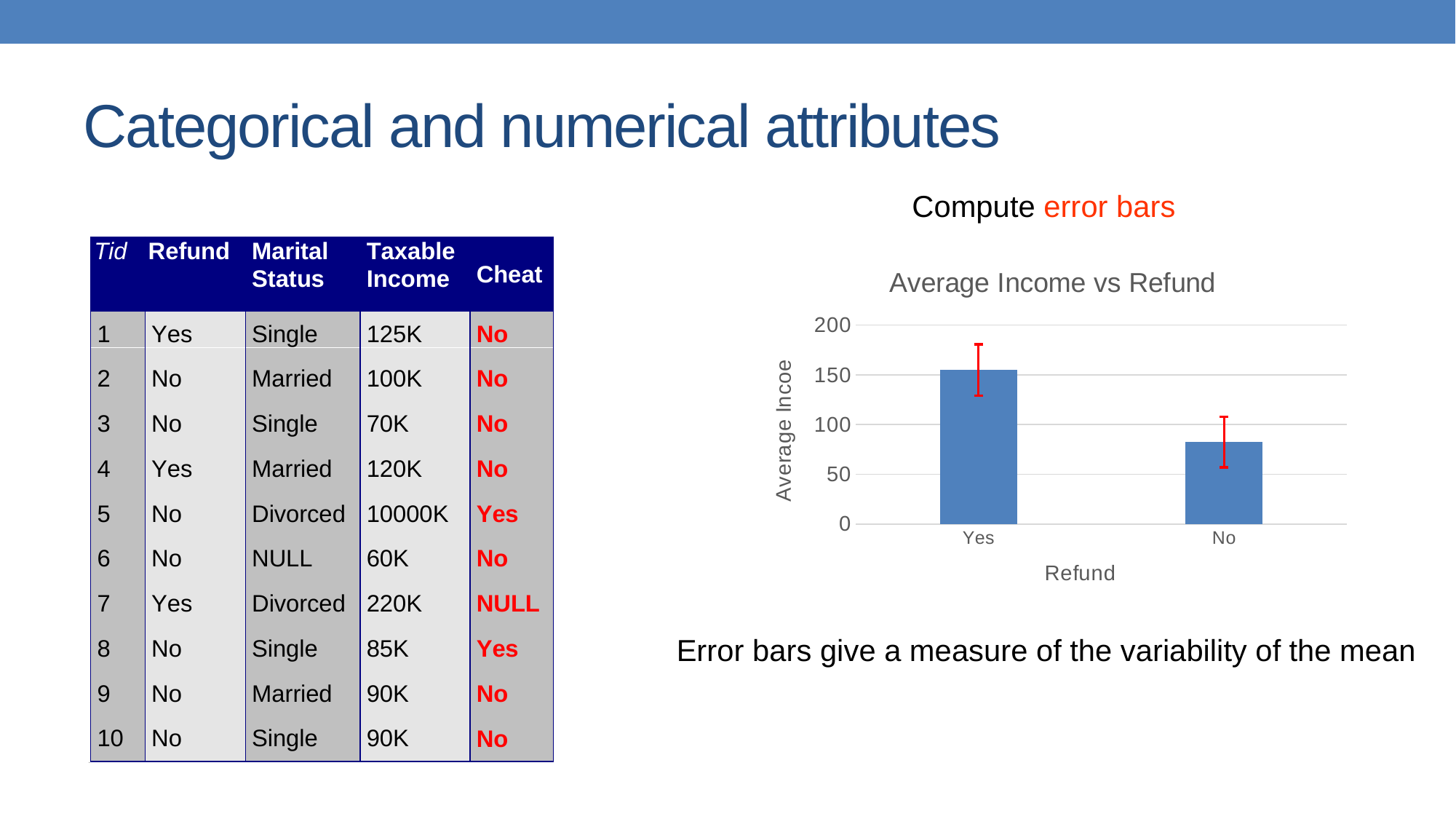
Which bar is taller, Yes or No? Yes Is the value for Yes greater or less than 200? less Is the value for Yes greater or less than 100? greater Which category has the highest bar in the chart? Yes How many categories are plotted on the x axis of the chart? 2 Is the value for No greater or less than 50? greater What kind of chart is shown on the slide? bar chart What is the label of the x axis of the chart? Refund What is the title of the chart? Average Income vs Refund Which category has the lowest bar in the chart? No